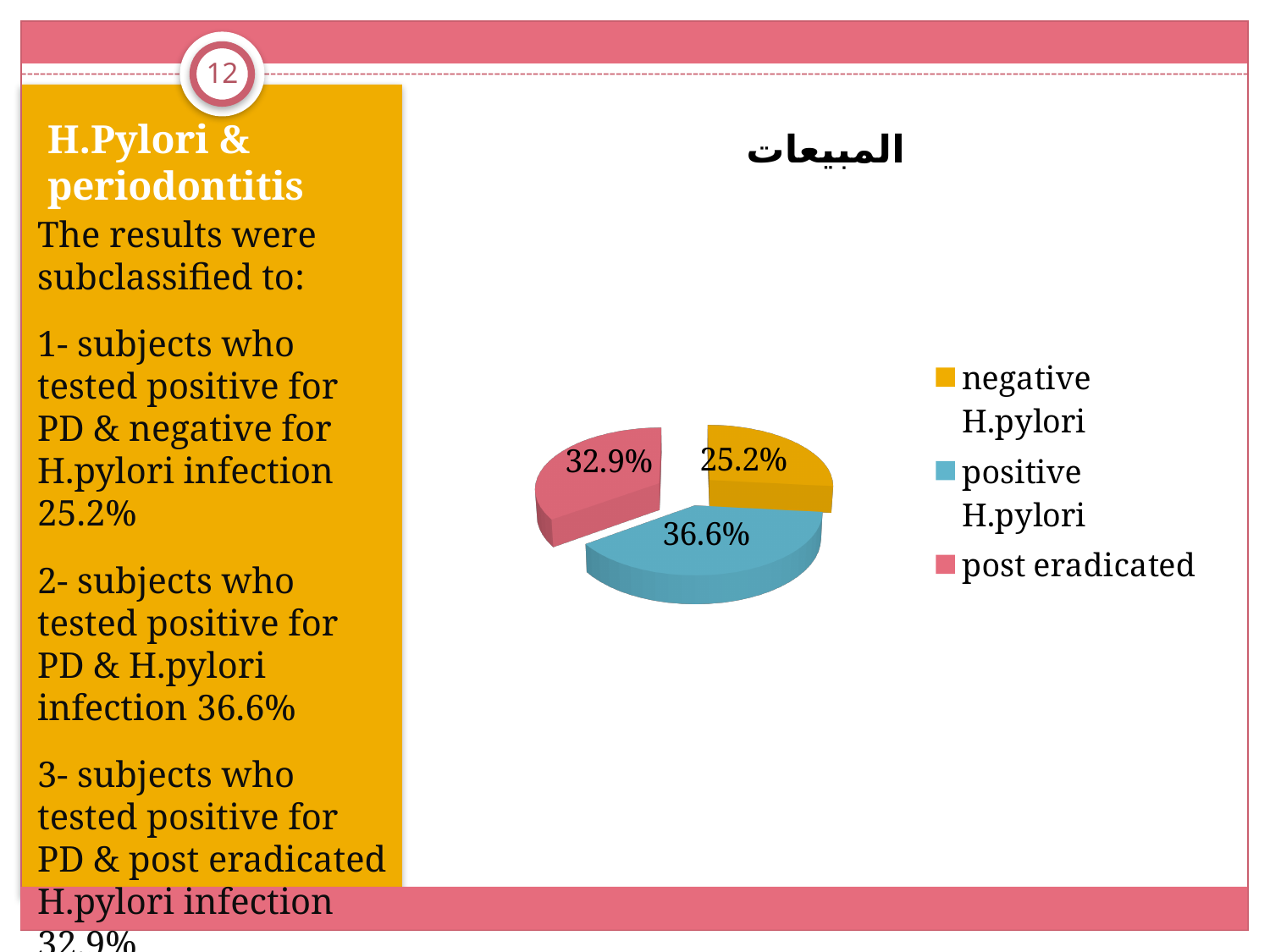
What is the value for the negative H.pylori slice? 25.2% Which category has the smallest slice of the pie? negative H.pylori What is the difference between the positive H.pylori and negative H.pylori values? 11.4% How many entries does the legend list? 3 How many slices does the pie chart have? 3 Which category has the largest slice of the pie? positive H.pylori What is the difference between the post eradicated and negative H.pylori values? 7.7% What is the value for the post eradicated slice? 32.9% What colour is the post eradicated slice? pink What kind of chart is shown on the slide? pie chart What is the value for the positive H.pylori slice? 36.6% Which is larger, the post eradicated slice or the negative H.pylori slice? post eradicated